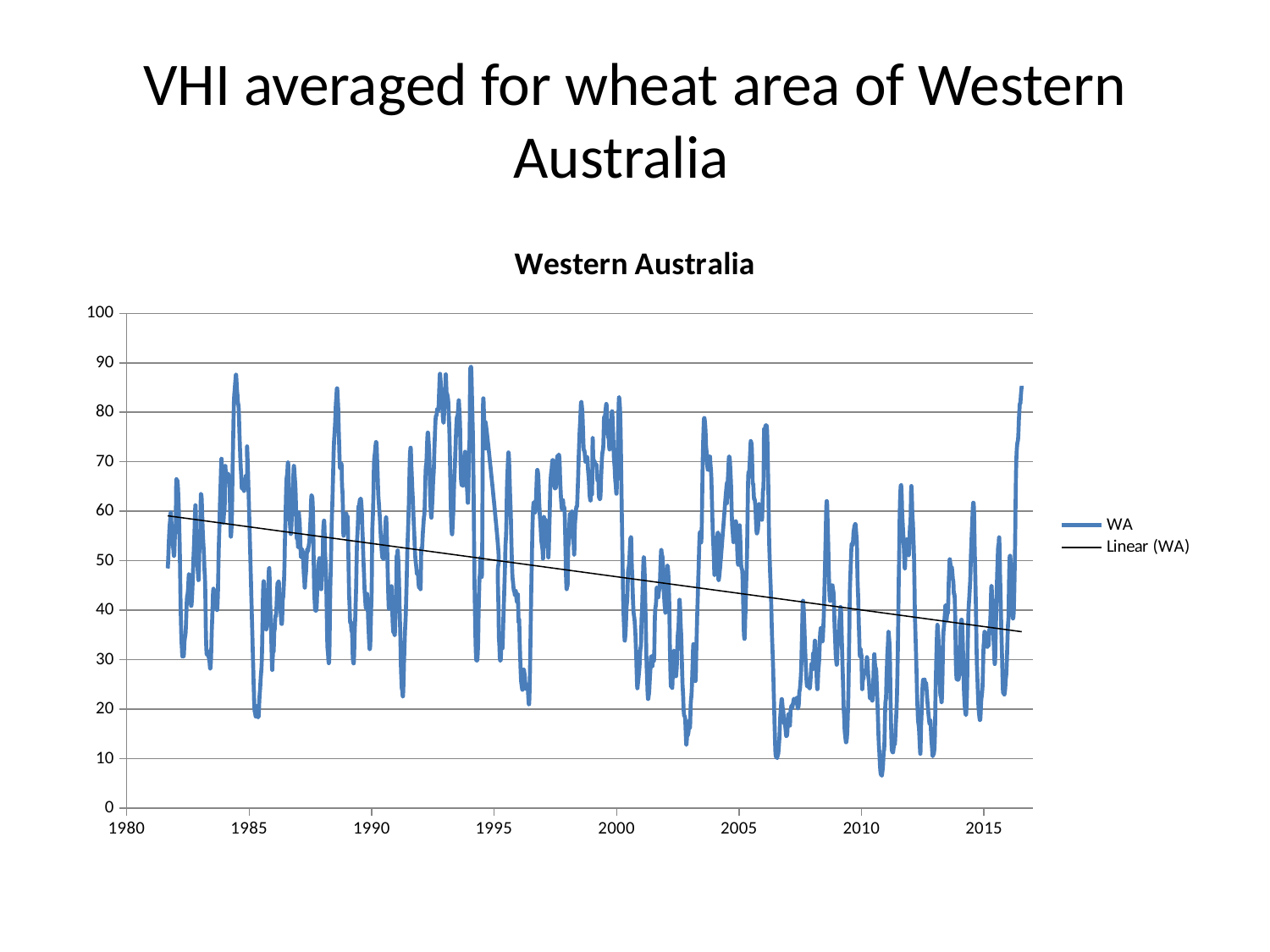
Does the WA series ever exceed 90 on the vertical axis? no What is the maximum value shown on the vertical axis? 100 What is the title of the chart? Western Australia What are the two entries in the chart's legend? WA and Linear (WA) How many series does the legend list? 2 Is the value of the Linear (WA) trend line at 2000 greater or less than 60? less Is the value of the Linear (WA) trend line at 2015 greater or less than 40? less What kind of chart is shown on the slide? line chart Does the linear trend line for WA rise or fall from 1980 to 2015? fall